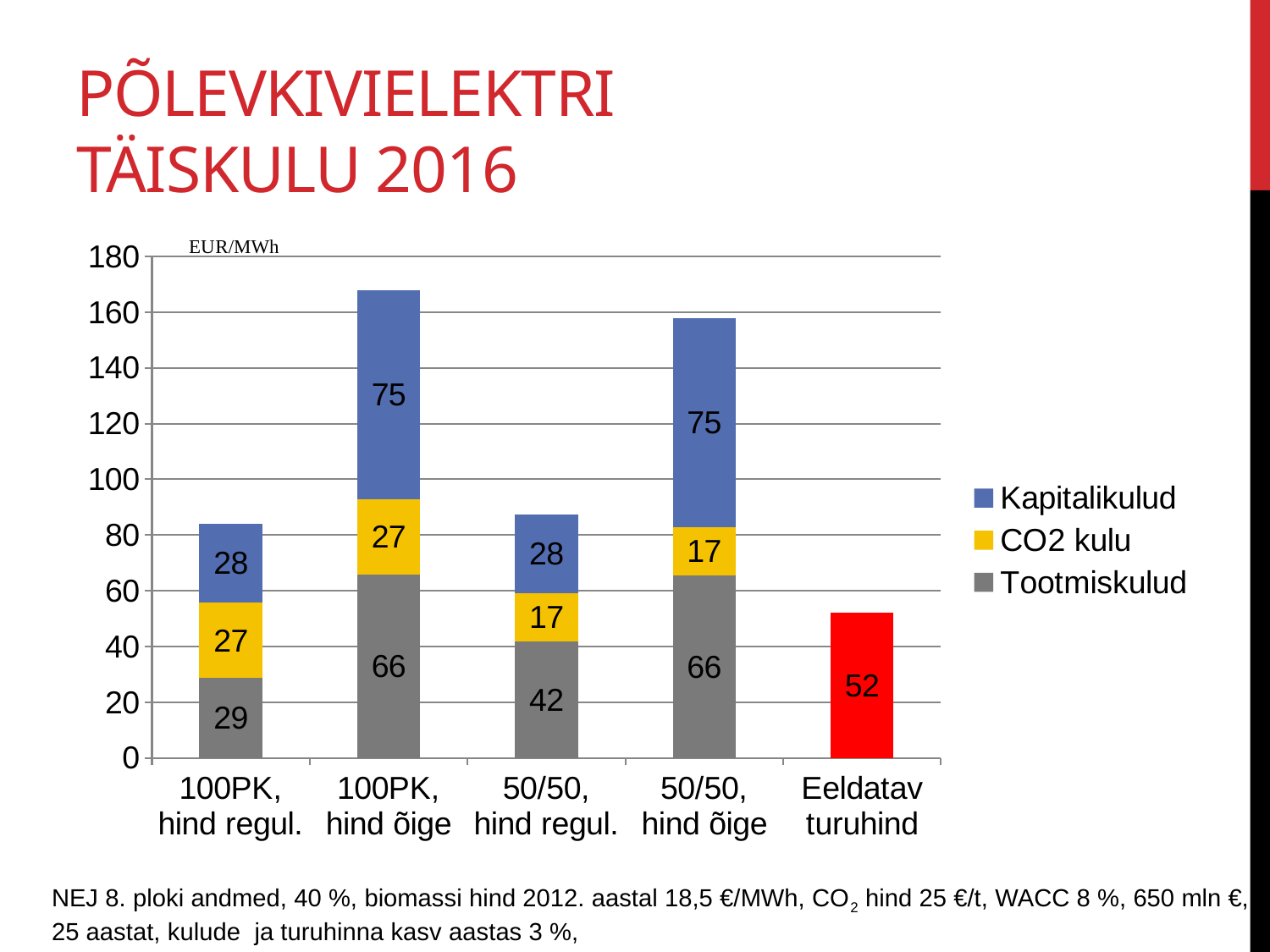
What is the value shown for "Eeldatav turuhind"? 52 How many series does the legend list? 3 Which category has the highest total bar? 100PK, hind õige What is the total of the stacked bar for "50/50, hind regul."? 87 What is the total of the stacked bar for "100PK, hind õige"? 168 What is the Tootmiskulud value for "100PK, hind regul."? 29 What is the difference between the Tootmiskulud values for "100PK, hind õige" and "100PK, hind regul."? 37 Which is larger: the CO2 kulu value for "100PK, hind regul." or for "50/50, hind regul."? 100PK, hind regul. What is the Kapitalikulud value for "50/50, hind õige"? 75 What unit is shown at the top of the vertical axis? EUR/MWh What type of chart is shown on the slide? stacked bar chart What is the CO2 kulu value for "50/50, hind regul."? 17